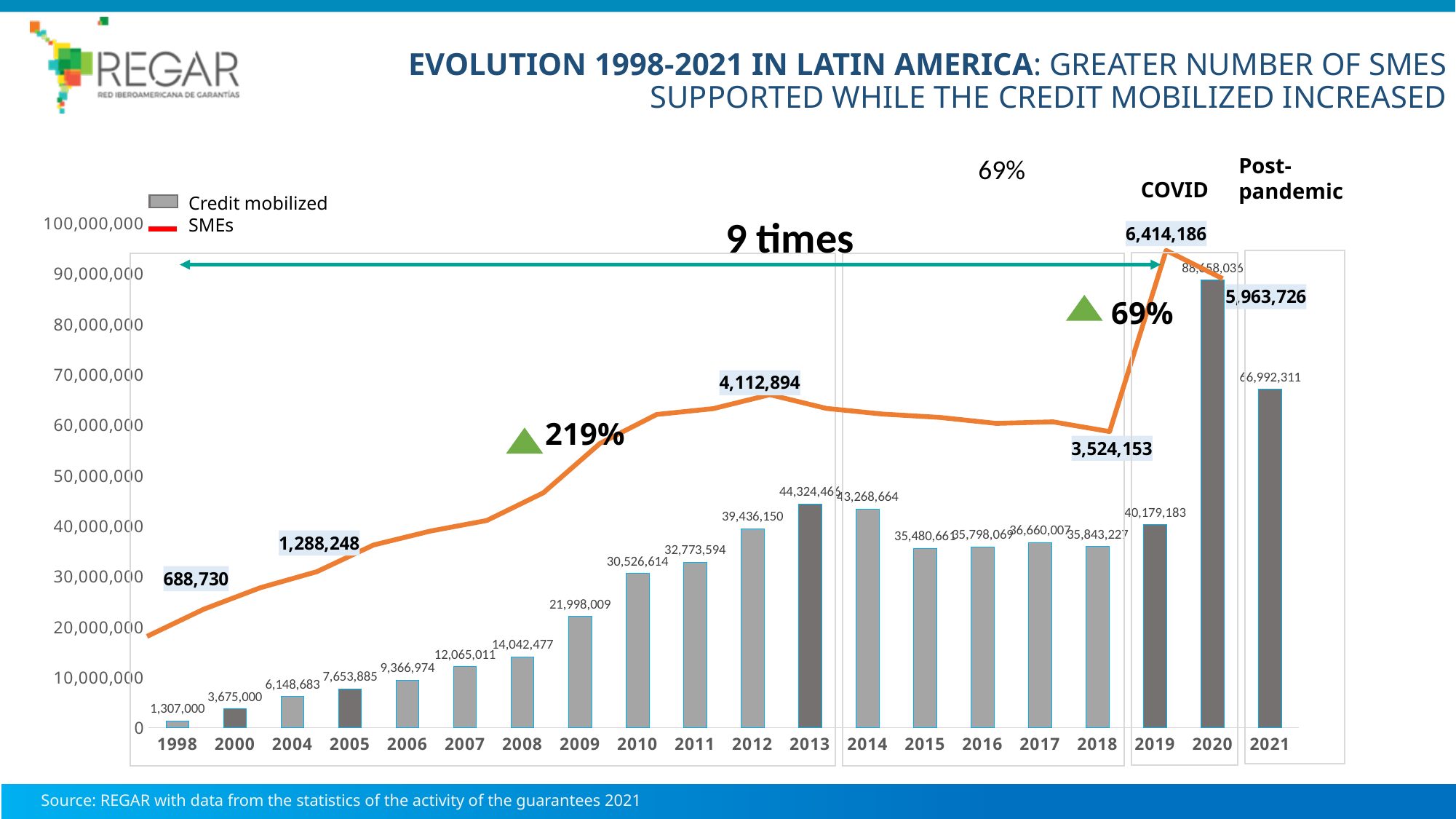
Is the Credit mobilized value for 2013 greater or less than 40,000,000? greater Which year has the highest Credit mobilized bar? 2020 Which year has a larger Credit mobilized value, 2014 or 2015? 2014 What is the SMEs value labelled for 2020? 6,414,186 How many years are shown on the x axis? 20 How many series does the legend list? 2 What is the Credit mobilized value for 2009? 21,998,009 What is the Credit mobilized value for 2019? 40,179,183 What kind of chart is this? Combined bar and line chart Which year has the lowest Credit mobilized bar? 1998 What is the Credit mobilized value for 2021? 66,992,311 What is the difference between the Credit mobilized values for 2021 and 2019? 26,813,128